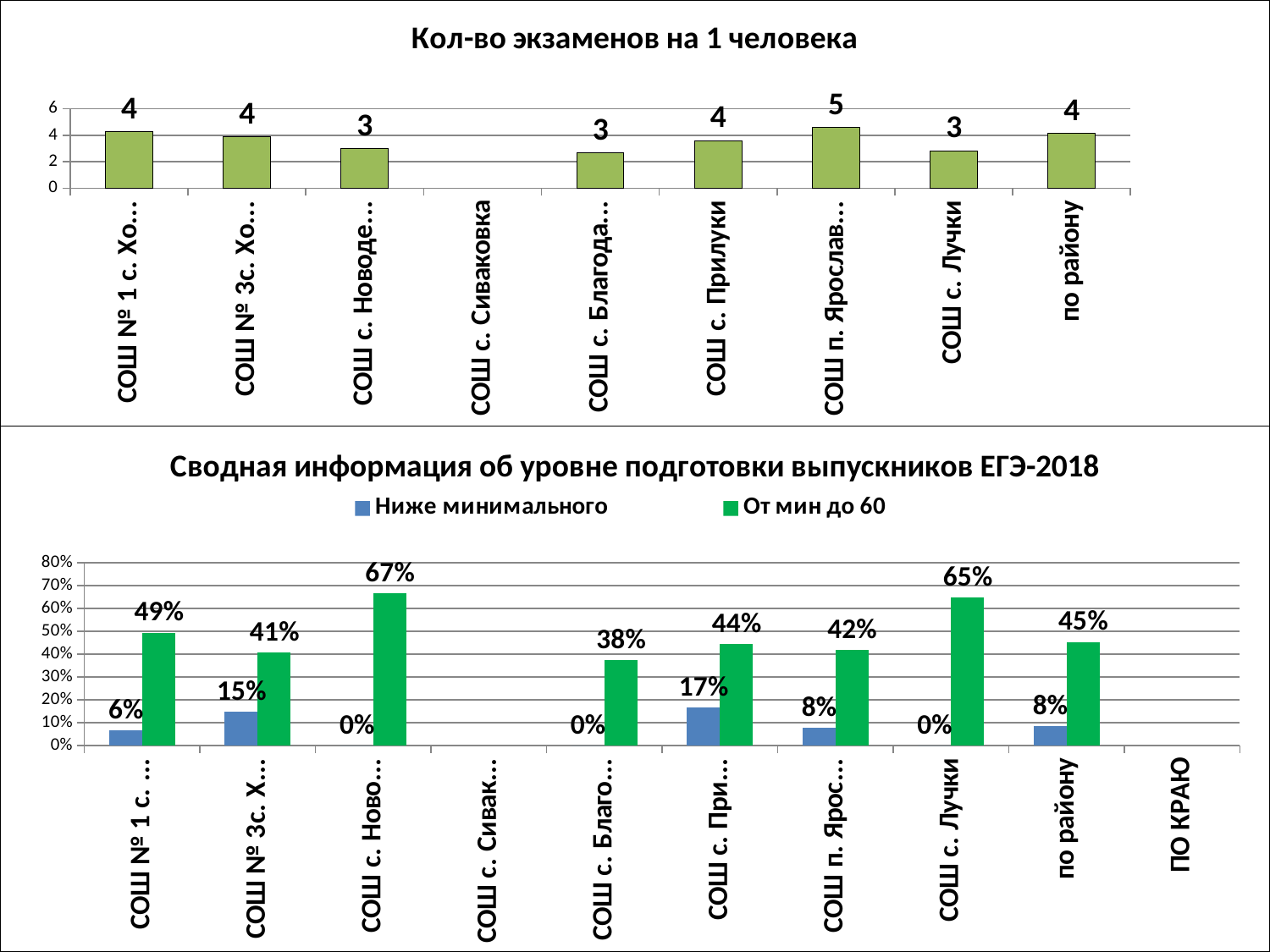
In the bottom chart 'Сводная информация об уровне подготовки выпускников ЕГЭ-2018', what is the difference between the 'От мин до 60' and 'Ниже минимального' values for по району? 37% In the top chart 'Кол-во экзаменов на 1 человека', what is the value for СОШ с. Лучки? 3 In the top chart 'Кол-во экзаменов на 1 человека', what is the value for СОШ с. Прилуки? 4 In the bottom chart 'Сводная информация об уровне подготовки выпускников ЕГЭ-2018', what is the 'От мин до 60' value for по району? 45% In the top chart 'Кол-во экзаменов на 1 человека', what is the highest data label shown? 5 What type of chart is the top chart 'Кол-во экзаменов на 1 человека'? bar chart In the bottom chart 'Сводная информация об уровне подготовки выпускников ЕГЭ-2018', what colour are the 'От мин до 60' bars? green In the bottom chart 'Сводная информация об уровне подготовки выпускников ЕГЭ-2018', how many series does the legend list? 2 In the bottom chart 'Сводная информация об уровне подготовки выпускников ЕГЭ-2018', what is the 'От мин до 60' value for СОШ с. Лучки? 65% In the bottom chart 'Сводная информация об уровне подготовки выпускников ЕГЭ-2018', what is the 'Ниже минимального' value for СОШ с. Прилуки? 17% In the top chart 'Кол-во экзаменов на 1 человека', what is the value for по району? 4 In the bottom chart 'Сводная информация об уровне подготовки выпускников ЕГЭ-2018', which is larger for СОШ с. Прилуки: 'Ниже минимального' or 'От мин до 60'? От мин до 60